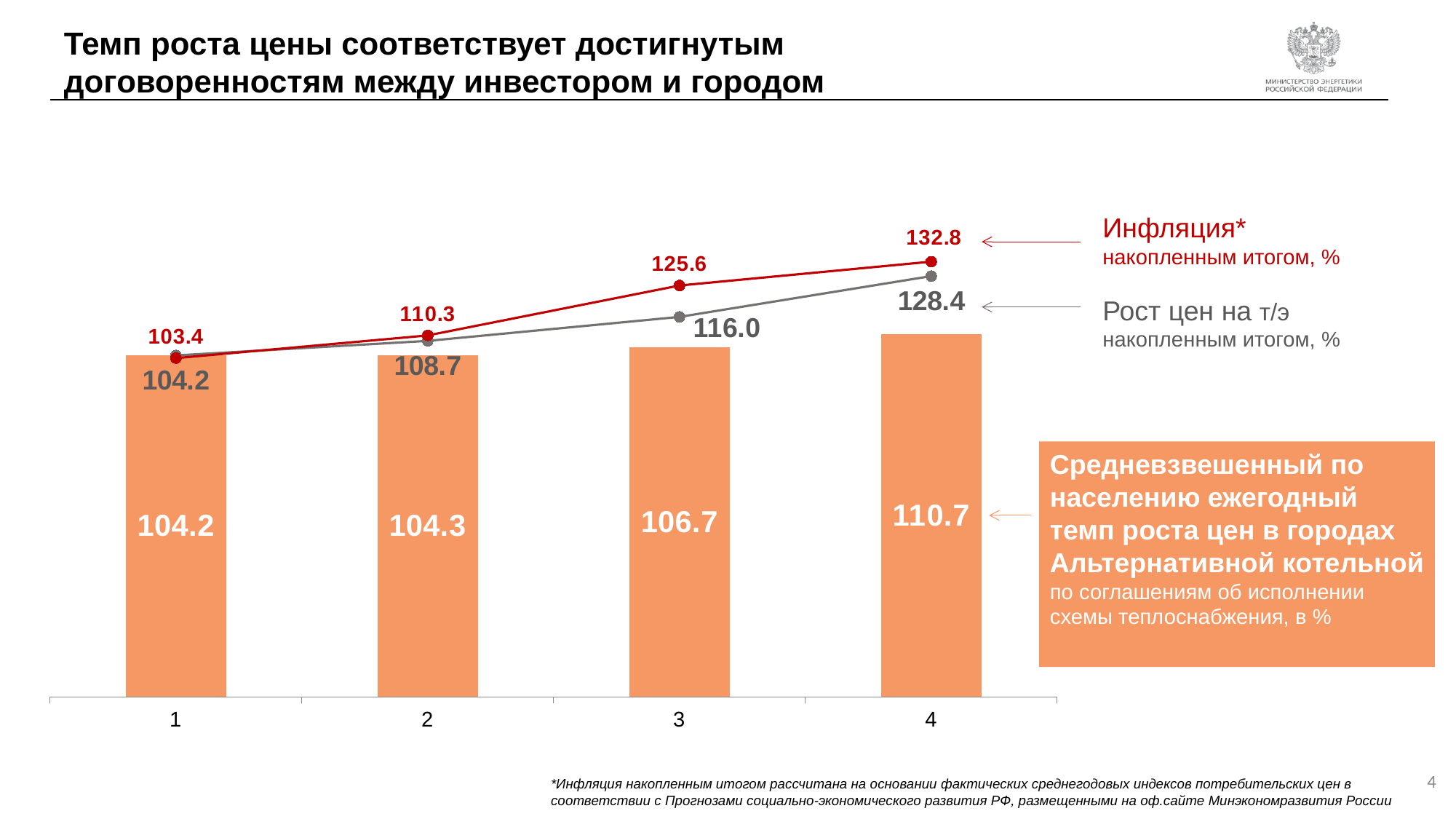
How many categories are shown on the x axis? 4 What colour are the bars on the chart? orange What is the value of the grey line (Рост цен на т/э накопленным итогом) at category 2? 108.7 What is the difference between the red line and the grey line at category 3? 9.6 Which category has the highest orange bar? 4 How many line series are plotted on the chart? 2 What kind of chart is shown on the slide? a combined bar and line chart What is the value of the red line (Инфляция накопленным итогом) at category 4? 132.8 Do the values of the grey line rise or fall from category 1 to category 4? rise What is the value of the orange bar for category 3? 106.7 Which category has the lowest value on the red inflation line? 1 At category 4, which is larger: the red inflation line or the grey price growth line? the red inflation line